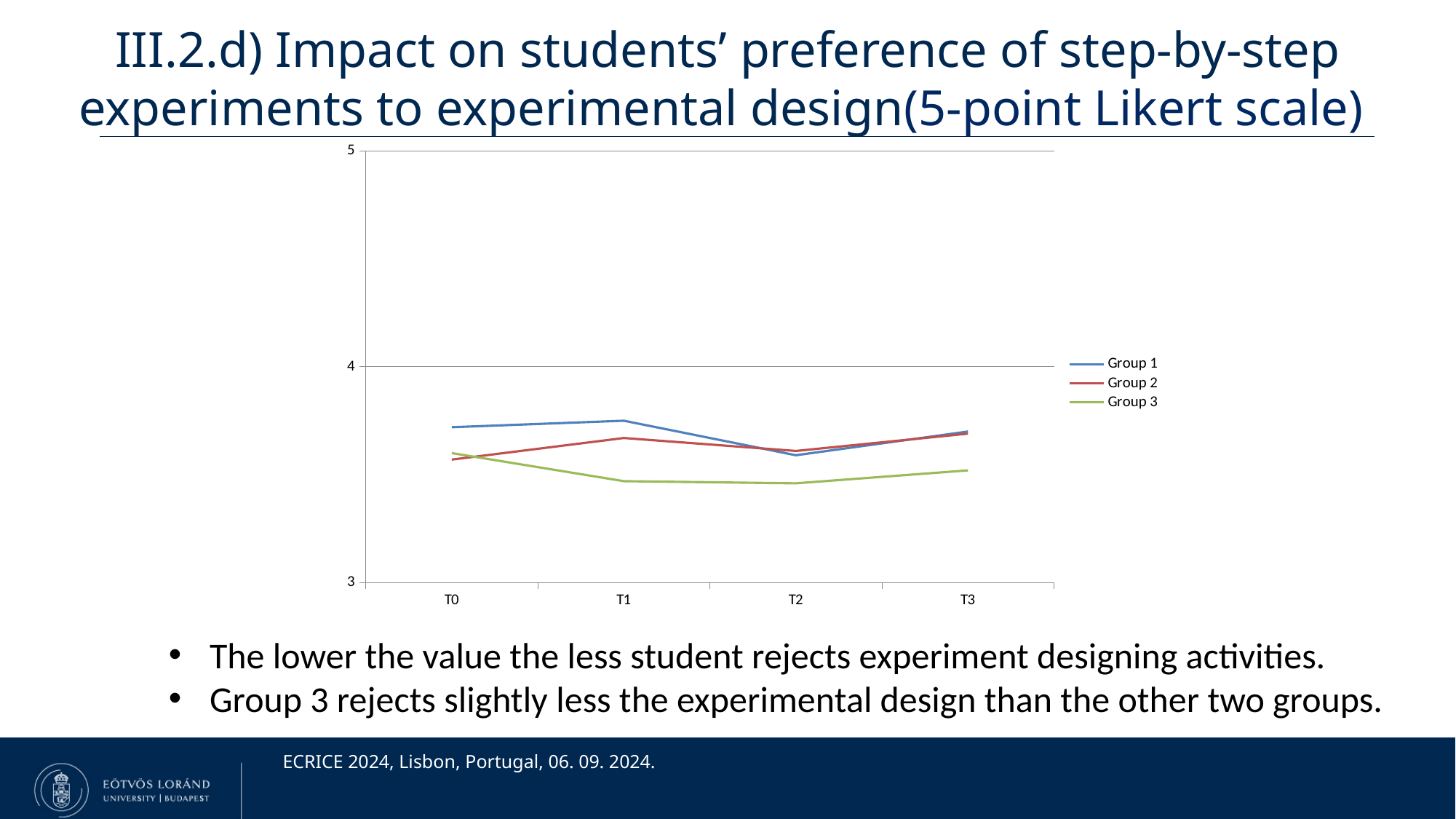
Which group has the highest value at T1? Group 1 At T0, which is larger: the value for Group 1 or the value for Group 2? Group 1 What kind of chart is shown on the slide? line chart Which series is plotted with the green line? Group 3 Is the value for Group 1 at T1 greater or less than 4? less Does the value for Group 1 rise or fall from T1 to T2? fall Does the value for Group 3 rise or fall from T0 to T1? fall Is the value for Group 3 at T2 greater or less than 3? greater At T1, which is larger: the value for Group 2 or the value for Group 3? Group 2 How many time points are shown on the x axis? 4 Which group has the lowest value at T3? Group 3 How many series does the legend list? 3